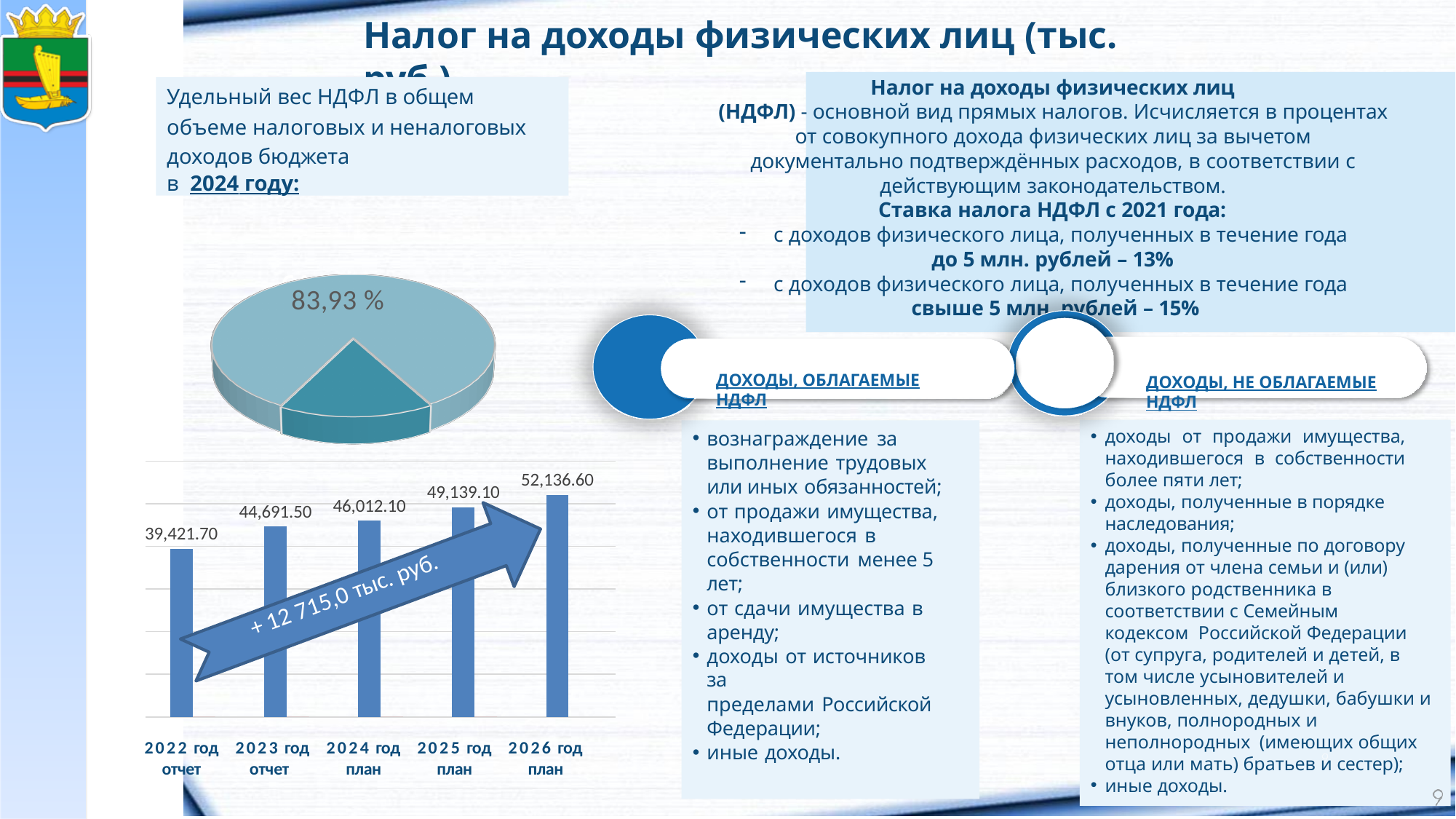
What type of chart is shown in the middle left of the slide, above the bar chart? pie chart On the bar chart at the bottom left, what is the value for 2026 год план? 52,136.60 On the bar chart at the bottom left, what is the difference between the values for 2023 год отчет and 2022 год отчет? 5,269.80 On the bar chart at the bottom left, what is the difference between the values for 2026 год план and 2025 год план? 2,997.50 What percentage label is printed on the pie chart? 83,93 % How many bars are shown on the bar chart at the bottom left? 5 On the bar chart at the bottom left, what is the value for 2024 год план? 46,012.10 On the bar chart at the bottom left, which year has the highest value? 2026 год план On the bar chart at the bottom left, which is larger: the value for 2025 год план or 2024 год план? 2025 год план On the bar chart at the bottom left, do the values rise or fall from 2022 to 2026? rise On the bar chart at the bottom left, what is the value for 2022 год отчет? 39,421.70 On the bar chart at the bottom left, which year has the lowest value? 2022 год отчет